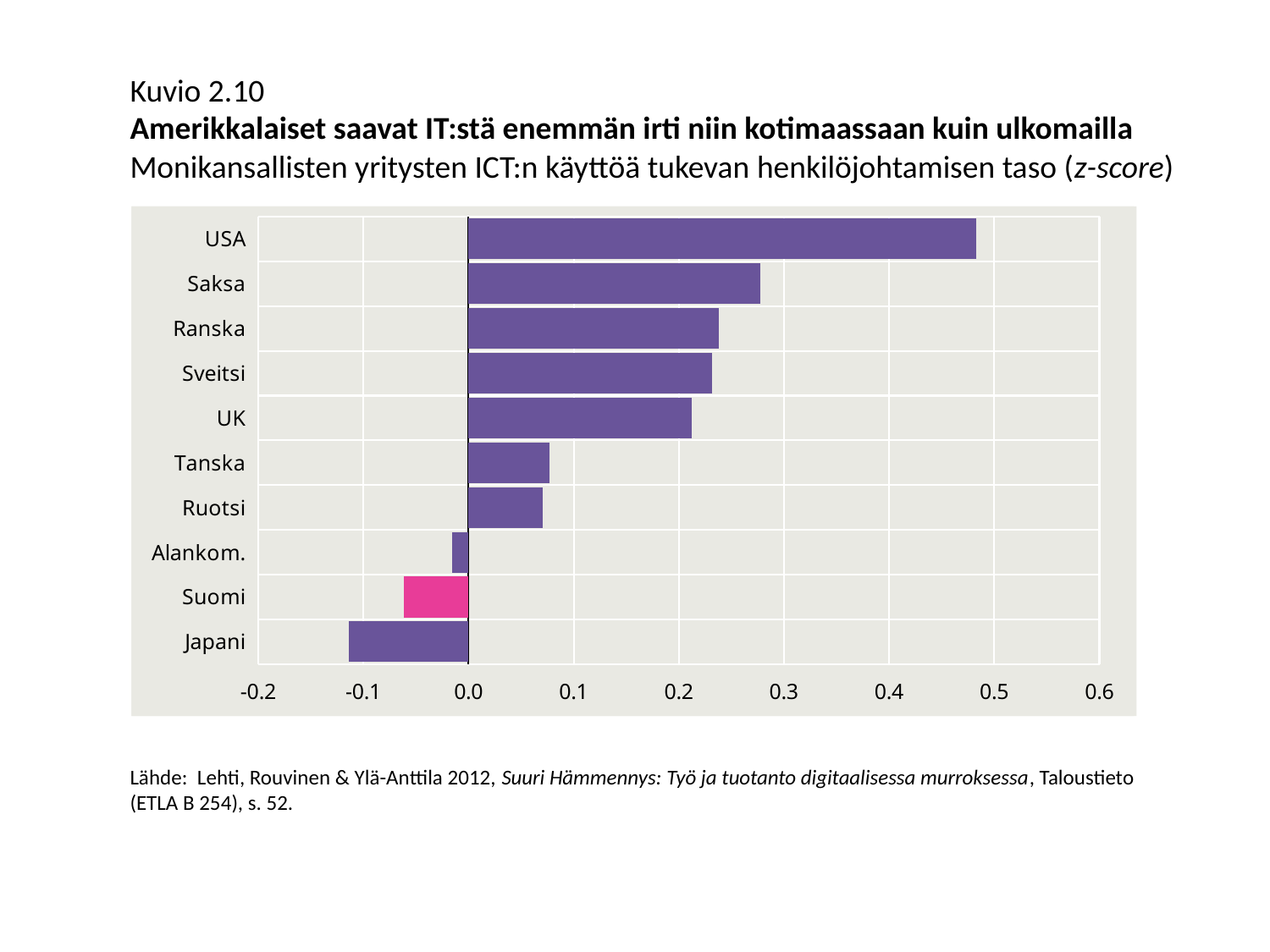
Which country's bar is highlighted in a different colour (pink) from the others? Suomi Is the value for UK greater or less than 0.1? greater What kind of chart is shown on the slide? bar chart Is the value for USA greater or less than 0.4? greater Is the value for Saksa greater or less than 0.2? greater How many countries are shown in the chart? 10 Which has the larger value, Ruotsi or Japani? Ruotsi Which has the larger value, USA or Saksa? USA Which country has the lowest value in the chart? Japani Which country has the highest value in the chart? USA